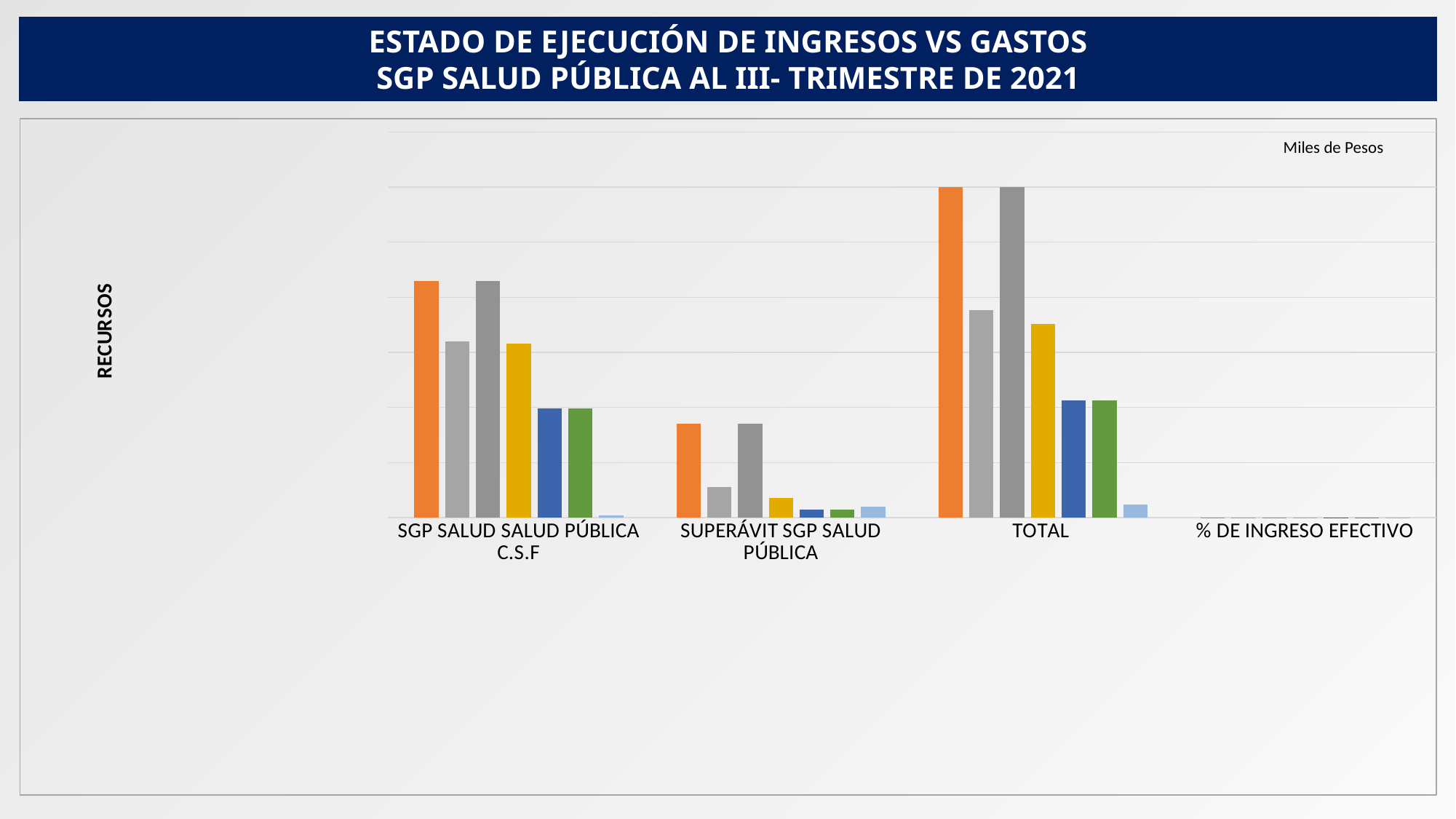
What unit is indicated in the top right corner of the chart? Miles de Pesos What kind of chart is shown on the slide? Bar chart Within the TOTAL category, is the orange bar taller or shorter than the yellow bar? Taller Is the orange bar taller for TOTAL or for SUPERÁVIT SGP SALUD PÚBLICA? TOTAL Which category has the shortest bars in the chart? % DE INGRESO EFECTIVO How many categories are shown along the x axis of the chart? 4 Which category has the tallest bars in the chart? TOTAL Is the orange bar taller for SGP SALUD SALUD PÚBLICA C.S.F or for SUPERÁVIT SGP SALUD PÚBLICA? SGP SALUD SALUD PÚBLICA C.S.F What is the title of the slide? ESTADO DE EJECUCIÓN DE INGRESOS VS GASTOS SGP SALUD PÚBLICA AL III- TRIMESTRE DE 2021 How many bars are plotted for the TOTAL category? 7